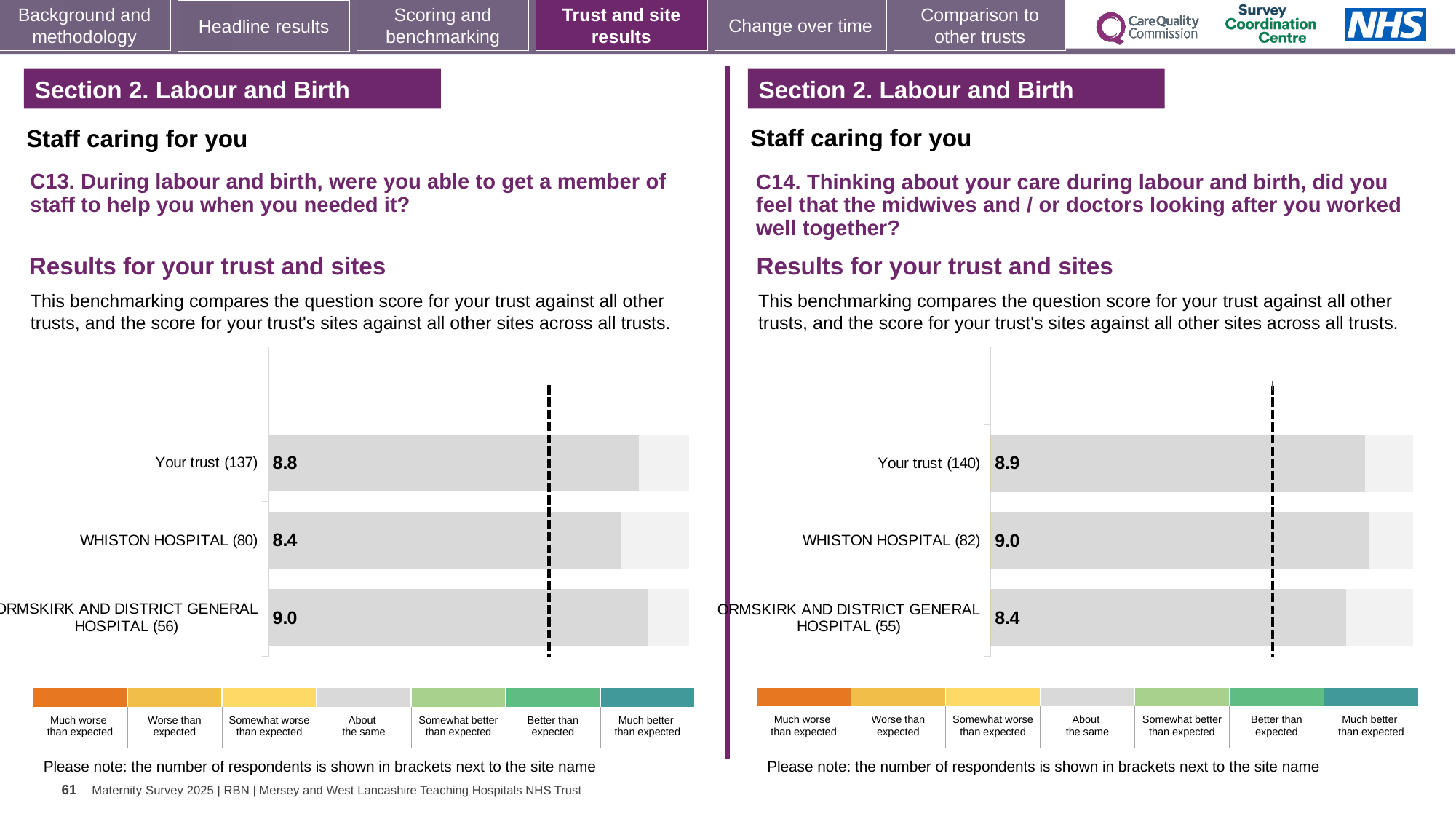
How many bars are plotted in the C13 chart on the left? 3 In the C14 chart on the right, is the score for Your trust larger or smaller than the score for Whiston Hospital? smaller What type of chart is used in the C14 chart on the right? Bar chart In the C14 chart on the right, what is the score for Whiston Hospital? 9.0 In the C14 chart on the right, what is the score for Ormskirk and District General Hospital? 8.4 In the C13 chart on the left, what is the difference between the scores for Ormskirk and District General Hospital and Whiston Hospital? 0.6 In the C13 chart on the left, how many respondents are shown in brackets for Your trust? 137 In the C13 chart on the left, what is the score for Your trust? 8.8 In the C13 chart on the left, what is the score for Whiston Hospital? 8.4 In the C14 chart on the right, what is the difference between the scores for Your trust and Ormskirk and District General Hospital? 0.5 In the C13 chart on the left, which site or trust has the highest score? Ormskirk and District General Hospital In the C14 chart on the right, which site or trust has the lowest score? Ormskirk and District General Hospital